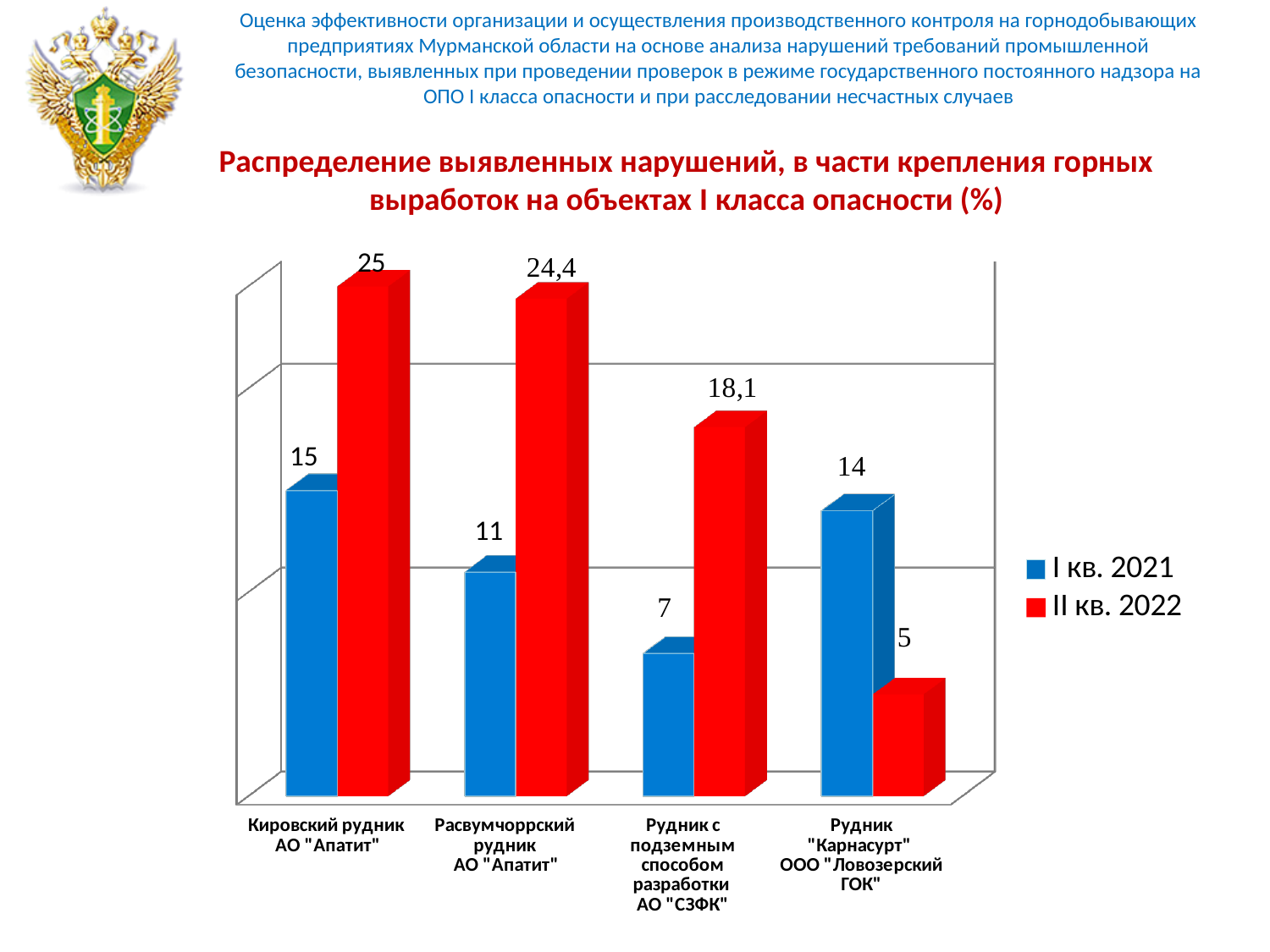
How many categories are shown on the x axis of the chart? 4 Which colour represents the II кв. 2022 series in the chart? Red What is the II кв. 2022 value for Рудник с подземным способом разработки АО "СЗФК"? 18,1 What is the I кв. 2021 value for Рудник "Карнасурт" ООО "Ловозерский ГОК"? 14 What kind of chart is shown on the slide? Bar chart For Рудник "Карнасурт" ООО "Ловозерский ГОК", which series has the larger value, I кв. 2021 or II кв. 2022? I кв. 2021 What is the value for Расвумчоррский рудник АО "Апатит" in the I кв. 2021 series? 11 What is the difference between the II кв. 2022 and I кв. 2021 values for Расвумчоррский рудник АО "Апатит"? 13,4 What is the value for Кировский рудник АО "Апатит" in the II кв. 2022 series? 25 Which category has the lowest value in the I кв. 2021 series? Рудник с подземным способом разработки АО "СЗФК" How many series does the legend list? 2 Which category has the highest value in the II кв. 2022 series? Кировский рудник АО "Апатит"